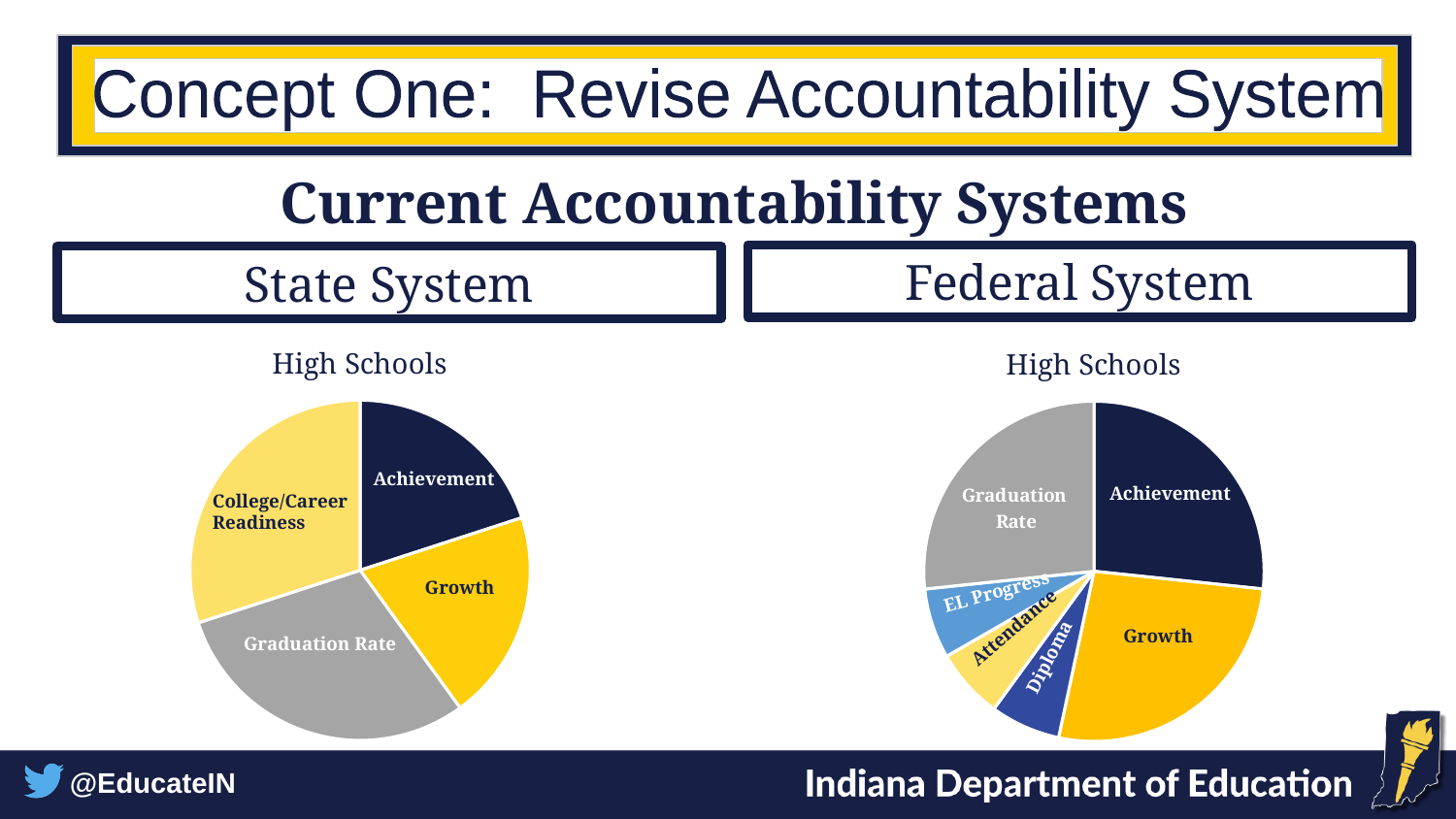
In the Federal System pie chart, which slice is larger: Achievement or EL Progress? Achievement Which slice appears in the State System pie chart but not in the Federal System pie chart? College/Career Readiness In the Federal System pie chart, which slice is larger: Growth or Diploma? Growth In the State System pie chart, which slice is larger: College/Career Readiness or Growth? College/Career Readiness What kind of chart is the State System chart? pie chart How many slices does the State System pie chart have? 4 What school level do both pie charts cover, according to the label above each chart? High Schools What kind of chart is the Federal System chart? pie chart How many slices does the Federal System pie chart have? 6